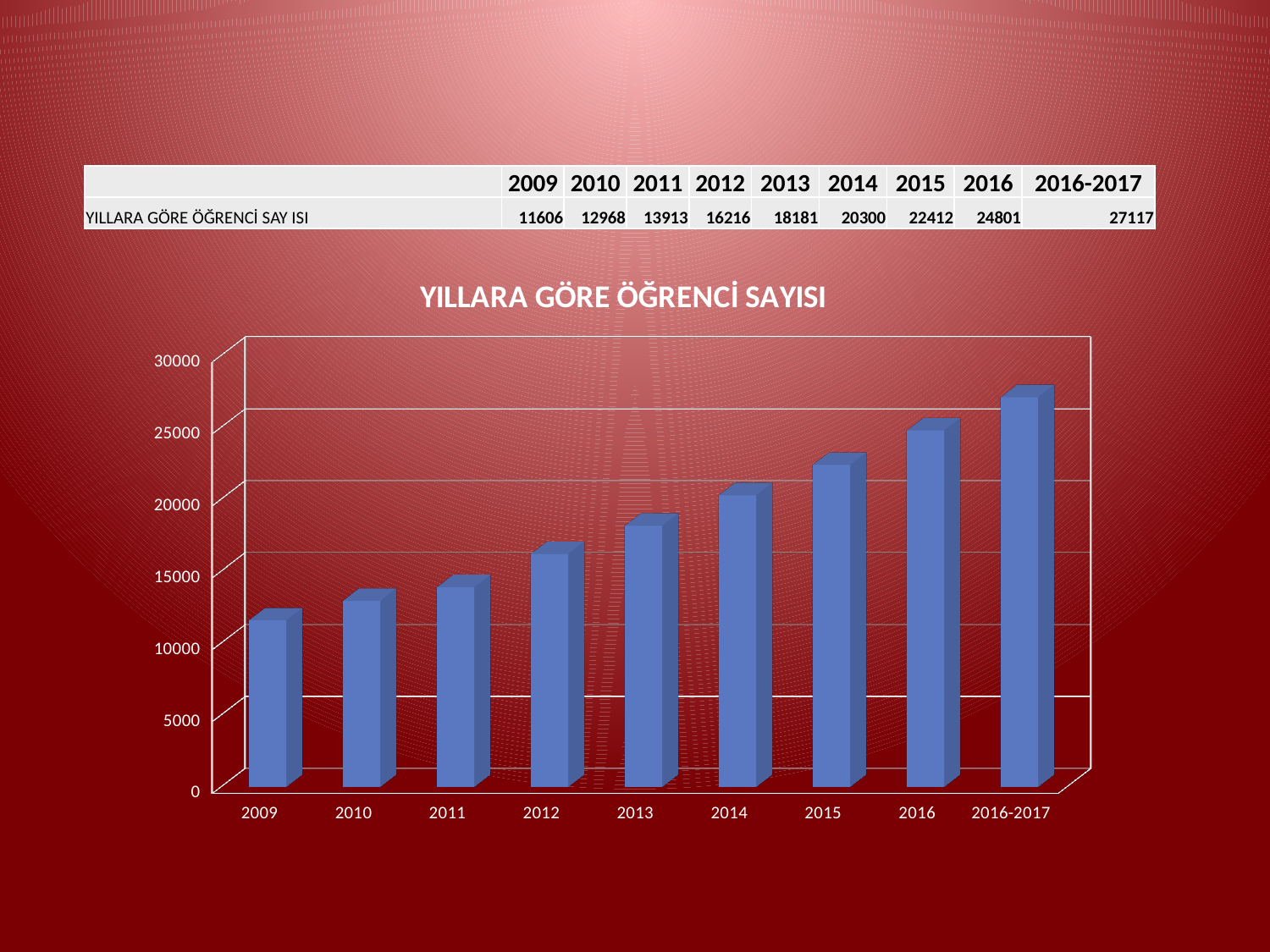
What kind of chart is shown on the slide? bar chart Which category has the lowest value in the chart? 2009 What is the difference between the values for 2014 and 2013? 2119 Which category has the highest value in the chart? 2016-2017 Which is larger, the value for 2012 or the value for 2011? 2012 Is the value for 2015 greater or less than 20000? greater What is the difference between the values for 2016-2017 and 2009? 15511 Do the values rise or fall from 2009 to 2016-2017? rise What is the value for 2009 in the chart? 11606 What is the value for 2014 in the chart? 20300 How many categories are shown on the x axis of the chart? 9 What is the value for 2016-2017 in the chart? 27117